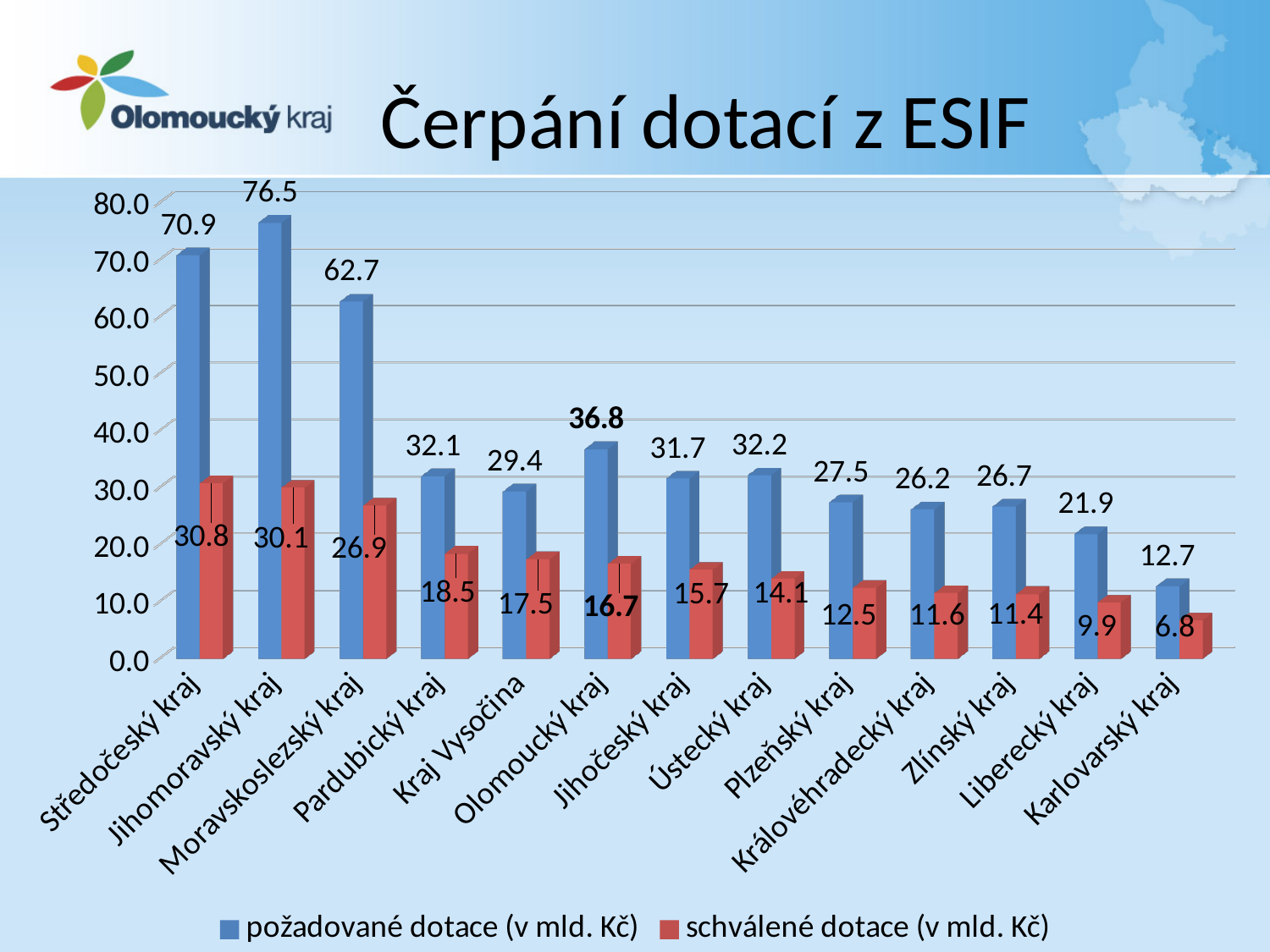
What is the difference in požadované dotace (v mld. Kč) between Jihomoravský kraj and Středočeský kraj? 5.6 What is the value of schválené dotace (v mld. Kč) for Středočeský kraj? 30.8 What is the title of the chart on the slide? Čerpání dotací z ESIF How many series does the legend list? 2 Which region has the highest value of požadované dotace (v mld. Kč)? Jihomoravský kraj Which region has the larger value of požadované dotace (v mld. Kč), Pardubický kraj or Liberecký kraj? Pardubický kraj What is the value of schválené dotace (v mld. Kč) for Karlovarský kraj? 6.8 Which region has the lowest value of schválené dotace (v mld. Kč)? Karlovarský kraj What kind of chart is shown on the slide? Bar chart What is the value of požadované dotace (v mld. Kč) for Olomoucký kraj? 36.8 What is the difference between požadované dotace and schválené dotace for Olomoucký kraj? 20.1 How many regions are shown on the x axis of the chart? 13